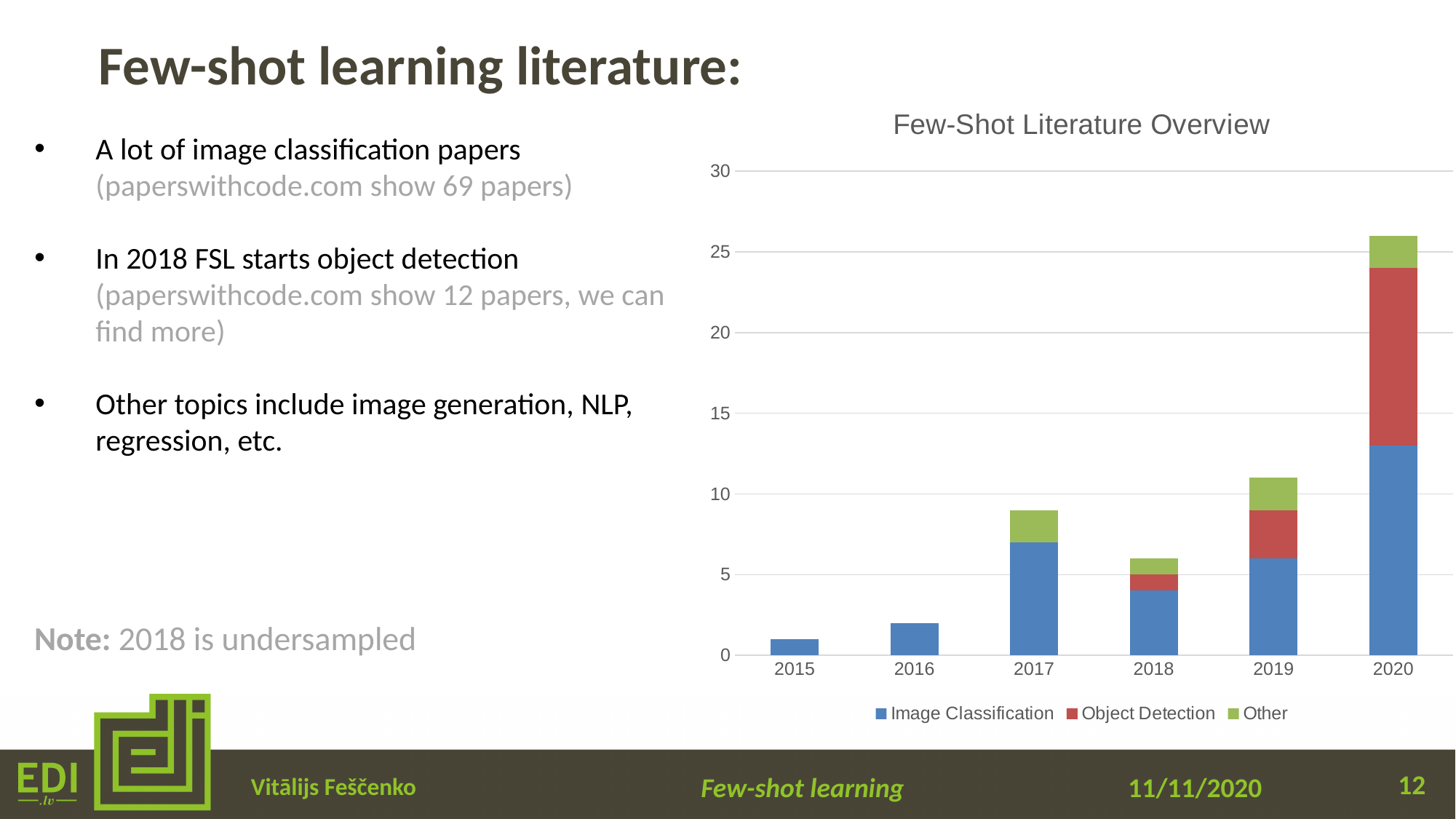
Which year has the larger total, 2017 or 2018? 2017 Which year has the tallest stacked bar? 2020 Is the total for 2020 greater or less than 25? greater Is the total for 2017 greater or less than 10? less What is the title of the chart? Few-Shot Literature Overview What kind of chart is shown on the slide? bar chart How many series does the legend list? 3 Which series is shown in red in the legend? Object Detection Which year has the shortest stacked bar? 2015 How many years are shown on the x axis? 6 Is the total for 2019 greater or less than 10? greater